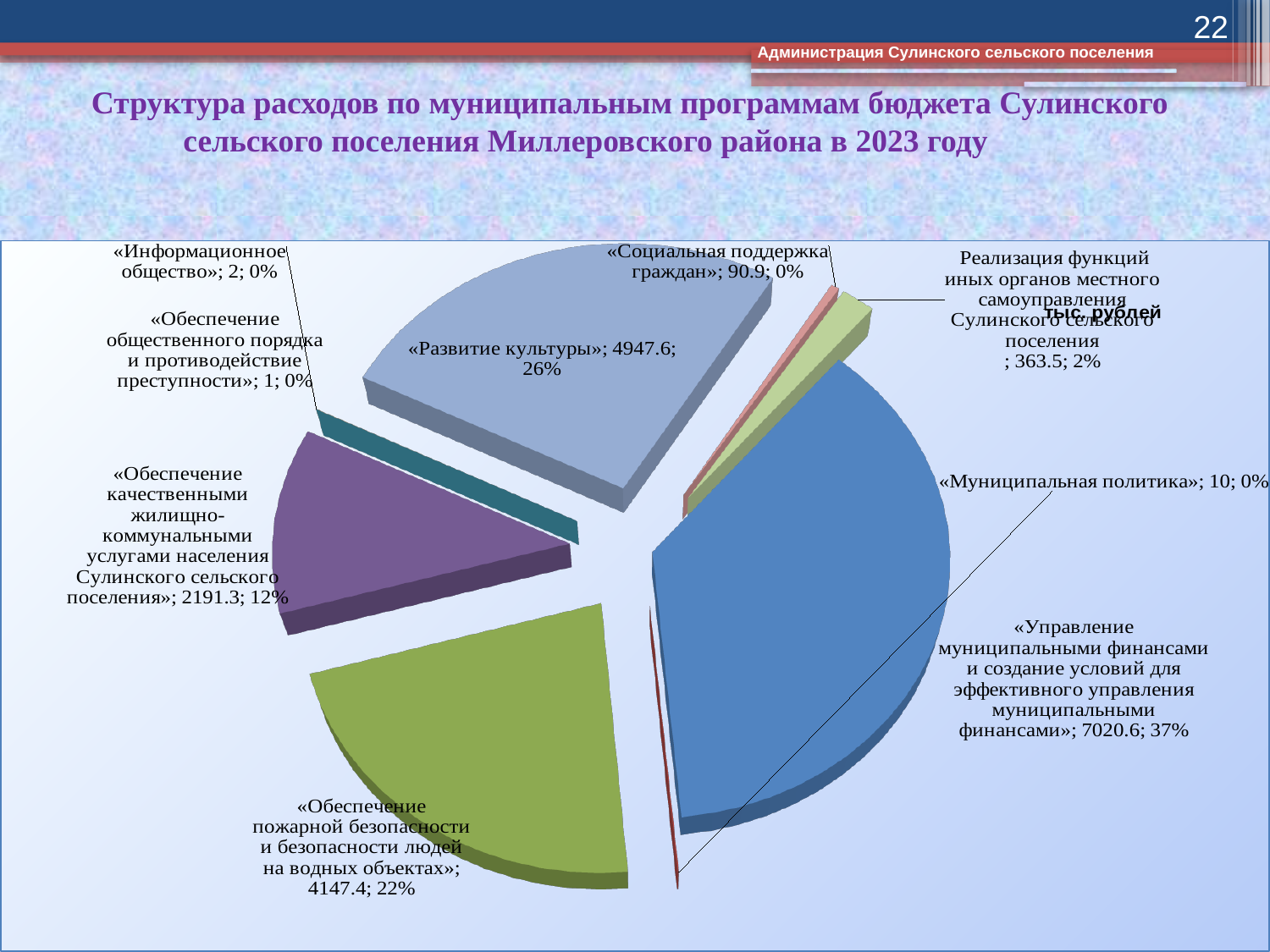
Which category has the largest slice of the pie? «Управление муниципальными финансами и создание условий для эффективного управления муниципальными финансами» What share of the pie does «Обеспечение качественными жилищно-коммунальными услугами населения Сулинского сельского поселения» represent? 12% What kind of chart is shown on the slide? pie chart How many slices (categories) does the pie chart have? 9 What is the value for «Развитие культуры»? 4947.6 In what units are the values in the chart expressed, according to the label on the slide? тыс. рублей Which is larger: the value for «Муниципальная политика» or the value for Реализация функций иных органов местного самоуправления Сулинского сельского поселения? Реализация функций иных органов местного самоуправления Сулинского сельского поселения What share of the pie does «Управление муниципальными финансами и создание условий для эффективного управления муниципальными финансами» represent? 37% Which category has the smallest value in the pie chart? «Обеспечение общественного порядка и противодействие преступности» What is the difference between the values for «Развитие культуры» and «Обеспечение пожарной безопасности и безопасности людей на водных объектах»? 800.2 What is the value for «Социальная поддержка граждан»? 90.9 What is the value for «Обеспечение пожарной безопасности и безопасности людей на водных объектах»? 4147.4